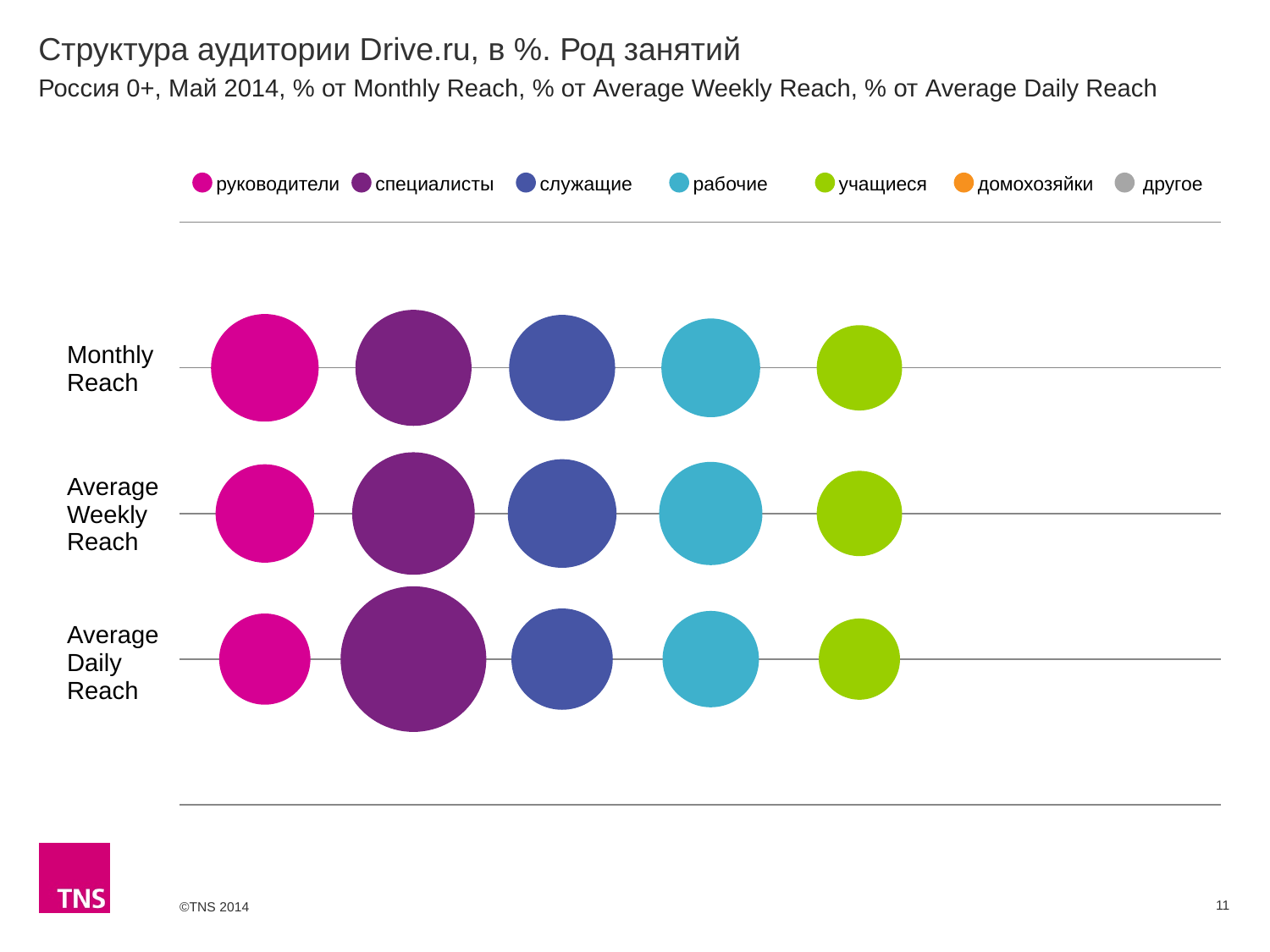
How many reach categories (rows) are plotted on the chart? 3 In the Average Daily Reach row, which bubble is larger: специалисты or руководители? специалисты Does the специалисты bubble grow or shrink going from Monthly Reach to Average Daily Reach? Grows What kind of chart is shown on the slide? Bubble chart Which occupation group has the largest bubble in the Average Daily Reach row? специалисты How many series does the legend list? 7 Is the руководители bubble larger in the Monthly Reach row or in the Average Daily Reach row? Monthly Reach Which legend entry is shown in orange? домохозяйки In the Average Daily Reach row, which bubble is larger: специалисты or учащиеся? специалисты What is the title of the chart on the slide? Структура аудитории Drive.ru, в %. Род занятий